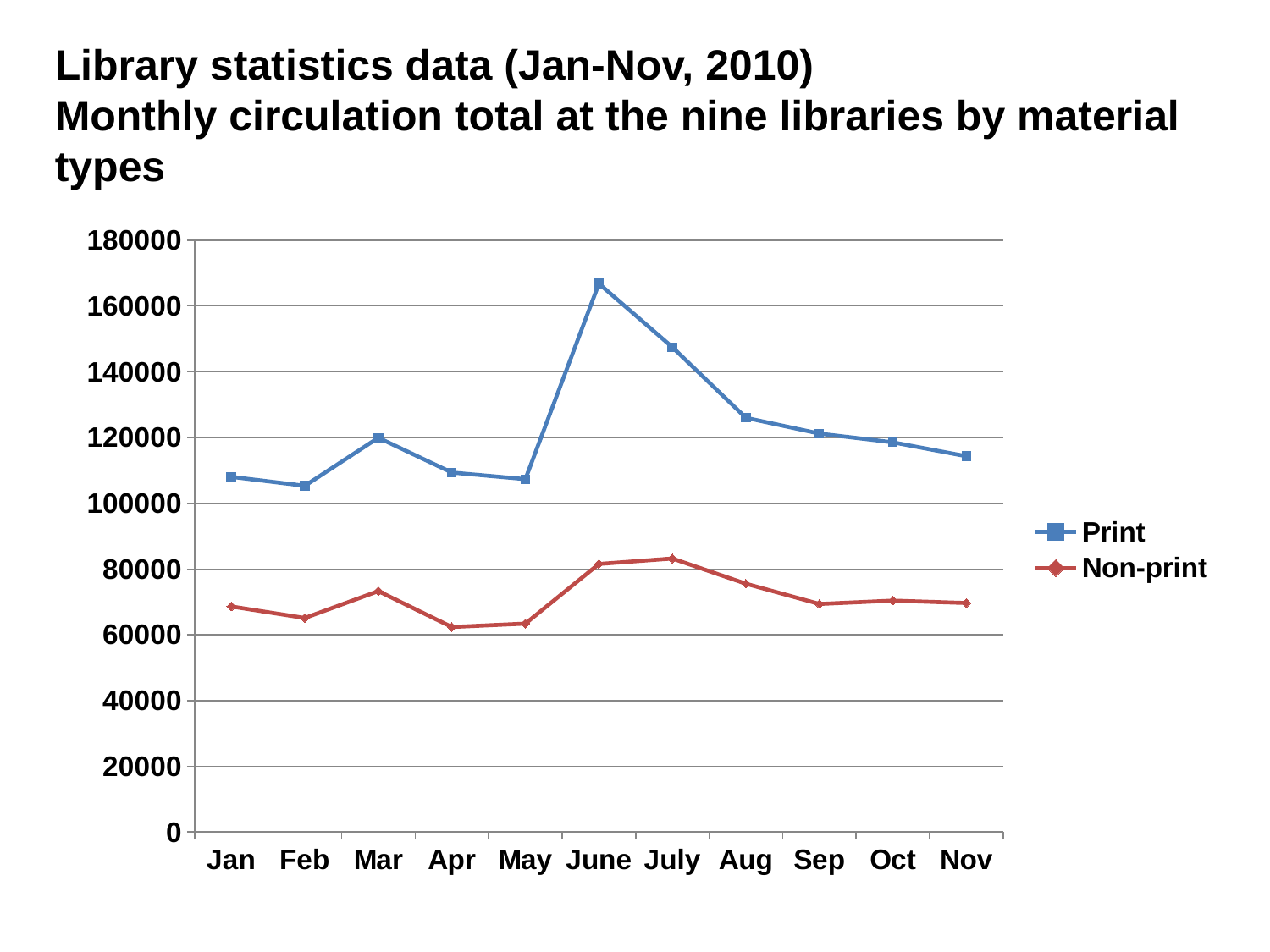
Which is larger, the Non-print value for Mar or the Non-print value for Apr? Mar Is the Print value for June greater or less than 160000? greater Does the Print series rise or fall from June to Nov? fall In which month does the Print series reach its highest value? June Is the Print value for Aug greater or less than 120000? greater What colour is the Print line? blue Is the Non-print value for July greater or less than 80000? greater What kind of chart is shown on the slide? line chart Which is larger, the Print value for June or the Print value for July? June How many series does the legend list? 2 How many months are plotted along the x axis? 11